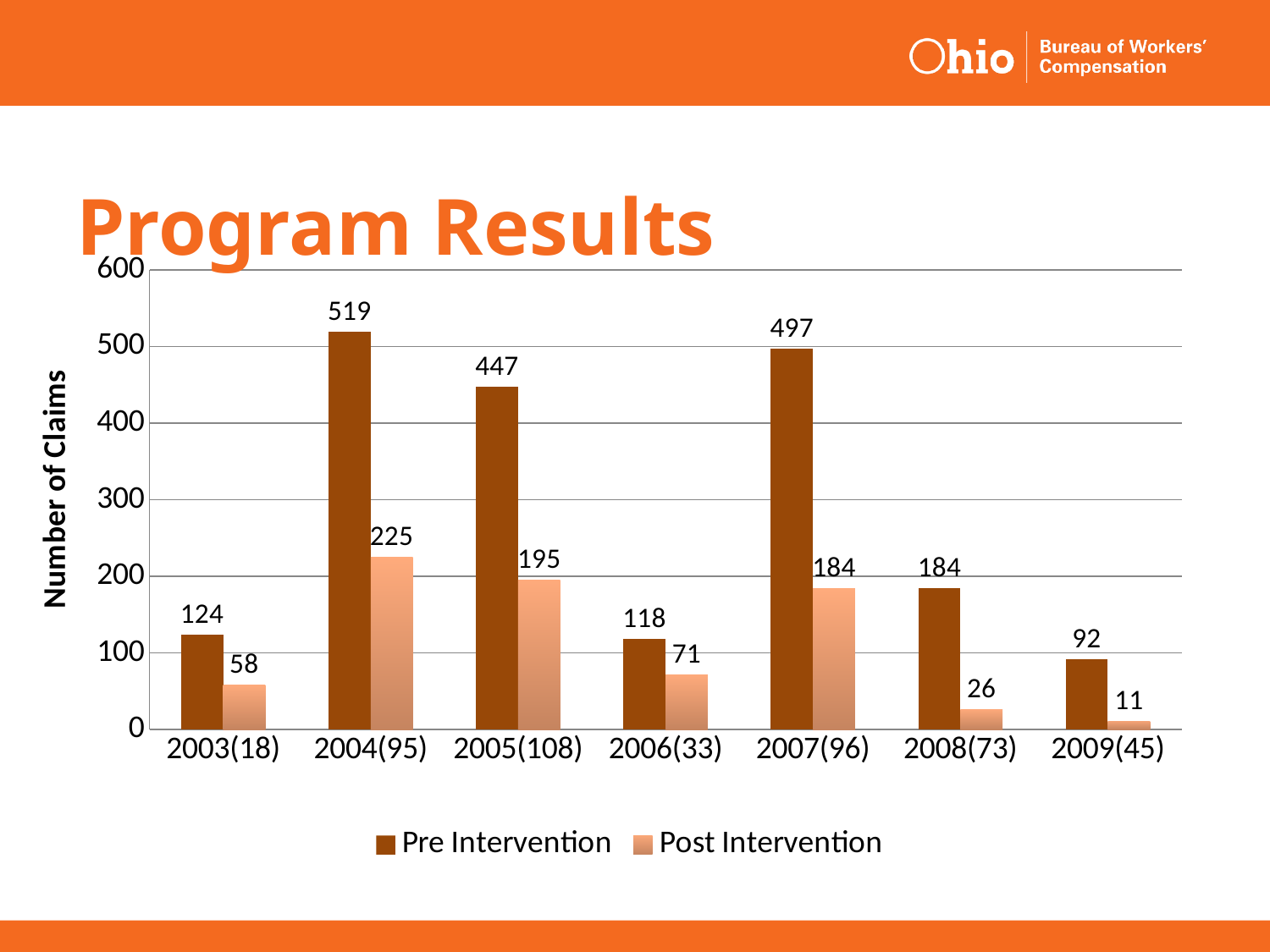
Which category has the lowest Post Intervention value? 2009(45) What is the Post Intervention value for 2006(33)? 71 How many series does the legend list? 2 What kind of chart is shown on the slide? bar chart What is the label on the vertical axis? Number of Claims Which is larger, the Post Intervention value for 2004(95) or the Post Intervention value for 2005(108)? 2004(95) Which category has the highest Pre Intervention value? 2004(95) What is the title of the chart? Program Results How many categories are shown on the x axis? 7 What is the difference between the Pre Intervention and Post Intervention values for 2007(96)? 313 What is the Pre Intervention value for 2004(95)? 519 Is the Pre Intervention value for 2005(108) greater or less than 400? greater